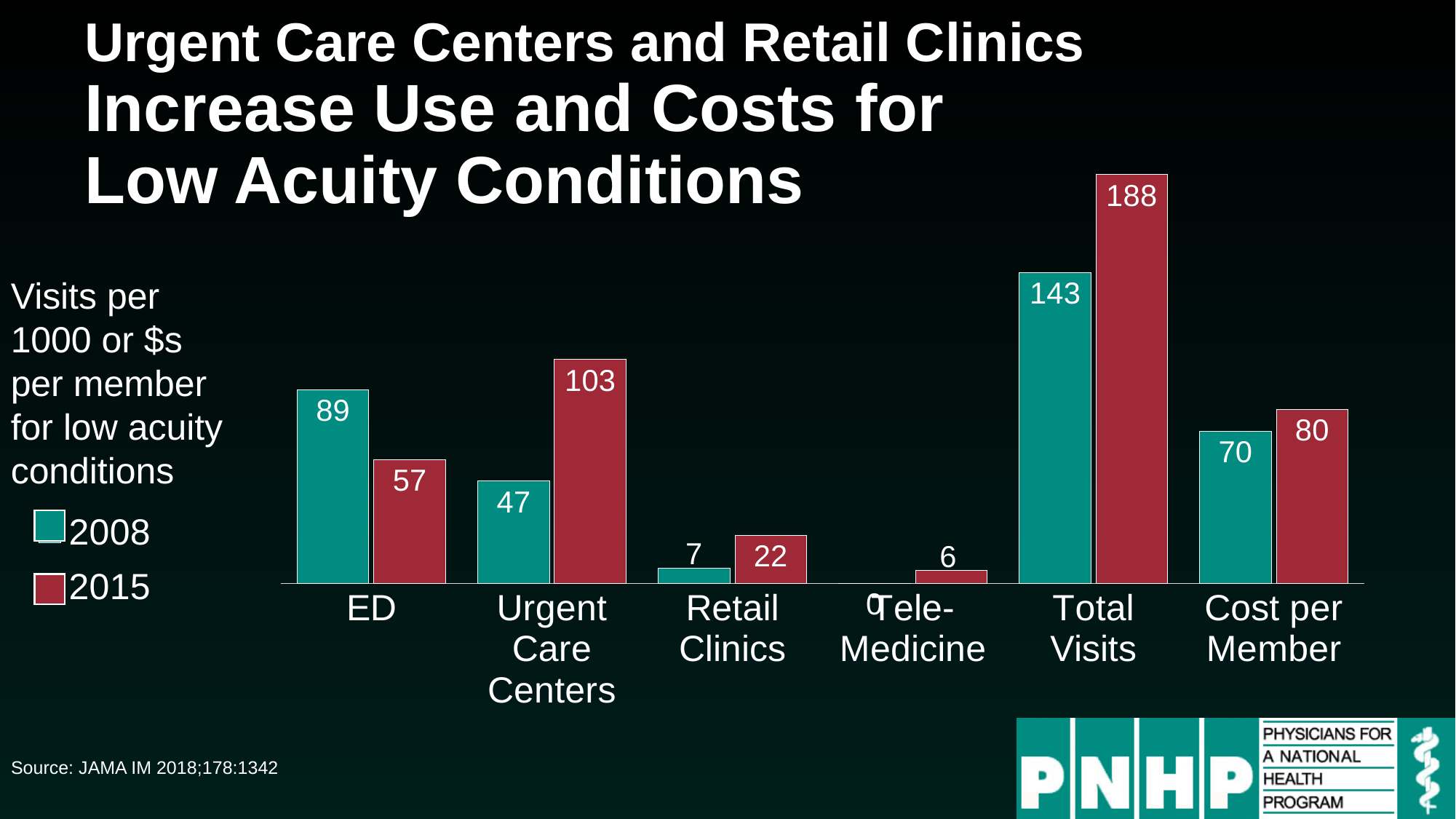
Which is larger for ED, the 2008 value or the 2015 value? 2008 Which category has the lowest 2008 value? Tele-Medicine What is the 2008 value for Tele-Medicine? 0 How many categories are shown on the x axis? 6 What is the 2008 value for ED? 89 What kind of chart is shown on the slide? Bar chart What is the 2015 value for Total Visits? 188 How many series does the legend list? 2 What is the 2015 value for Urgent Care Centers? 103 Which colour represents the 2015 series? Red What is the difference between the 2015 and 2008 values for Retail Clinics? 15 Which category has the highest 2015 value? Total Visits